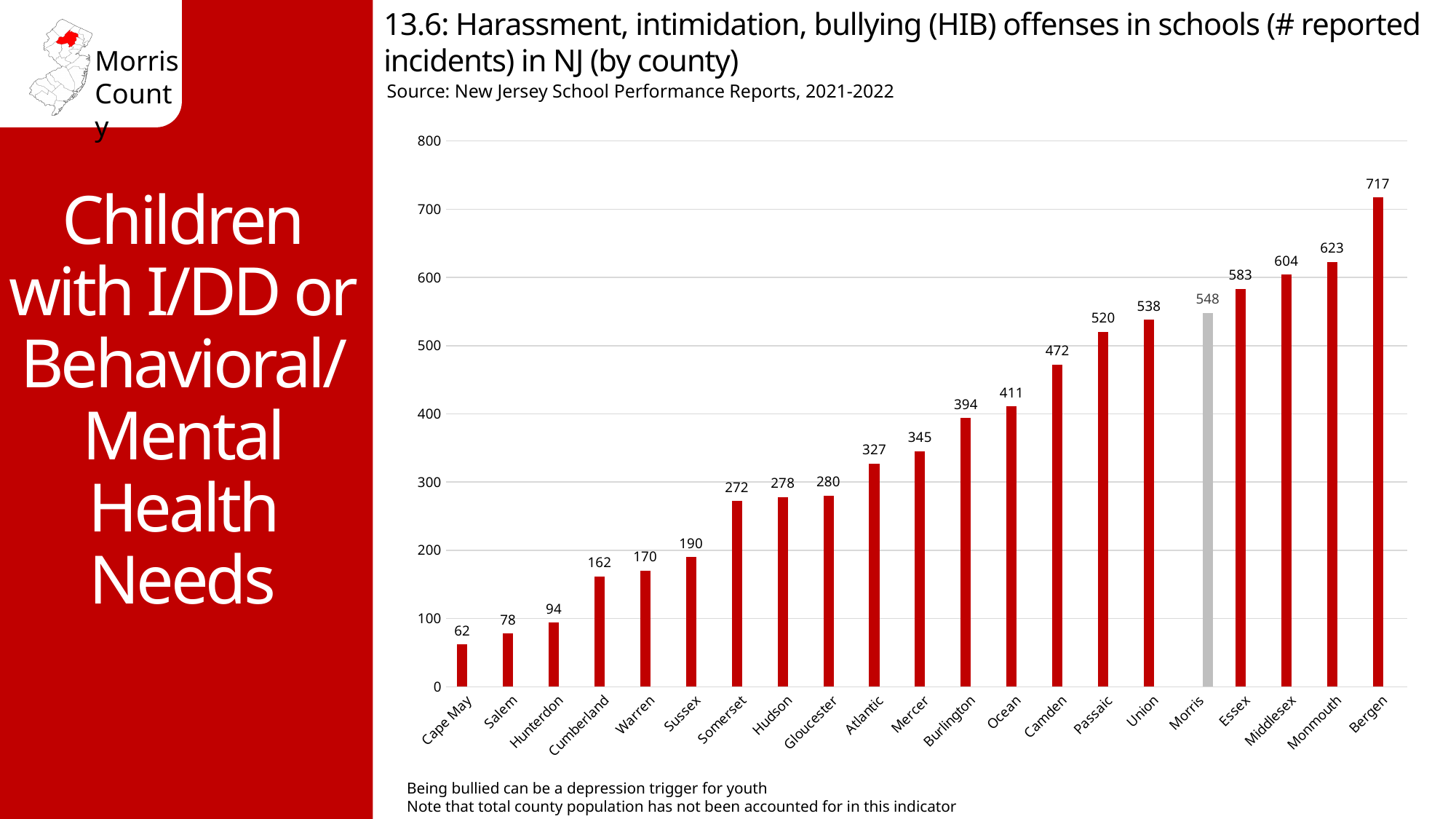
Is the value for Ocean greater or less than 400? greater What is the number of reported HIB incidents for Hudson county? 278 Which county's bar is coloured grey instead of red? Morris Which county has more reported HIB incidents, Passaic or Camden? Passaic Which county has the lowest number of reported HIB incidents? Cape May What is the difference in reported HIB incidents between Bergen and Morris? 169 Do the values rise or fall moving from left to right along the x axis? Rise What kind of chart is shown on the slide? Bar chart Which county has the highest number of reported HIB incidents? Bergen How many counties are shown on the chart? 21 What is the difference in reported HIB incidents between Salem and Cape May? 16 What is the number of reported HIB incidents for Morris county? 548